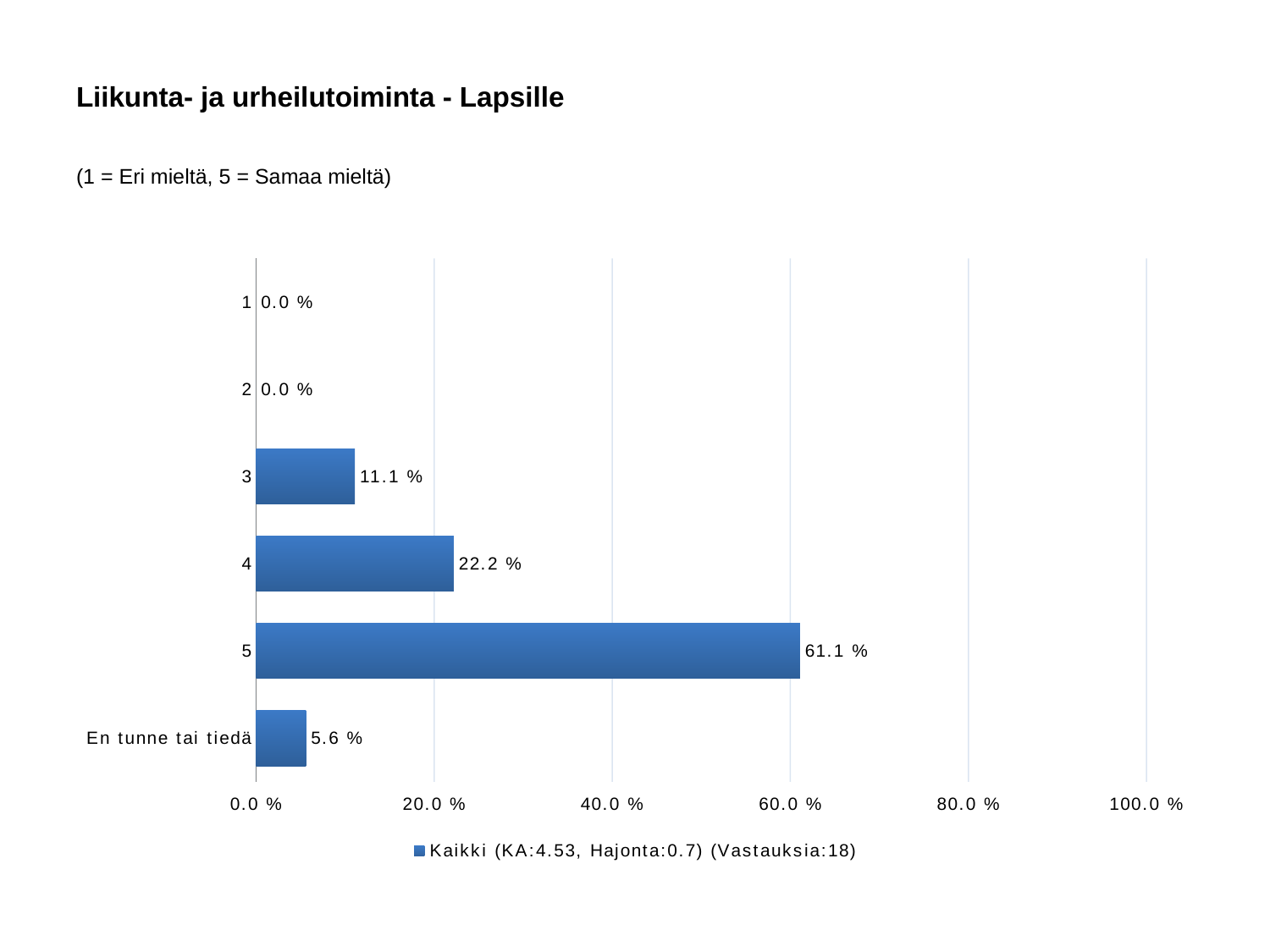
What is the value shown for the category 'En tunne tai tiedä'? 5.6 % How many series does the legend list? 1 Is the value for rating 5 greater or less than 60.0 %? greater Which category has the highest value? 5 What is the value shown for rating 3? 11.1 % What percentage of respondents chose rating 5? 61.1 % How many responses (Vastauksia) does the legend report? 18 What is the difference between the values for rating 5 and rating 4? 38.9 % Which is larger, the value for rating 3 or the value for 'En tunne tai tiedä'? 3 How many categories are shown on the y axis? 6 What is the value shown for rating 4? 22.2 % What kind of chart is shown on the slide? bar chart